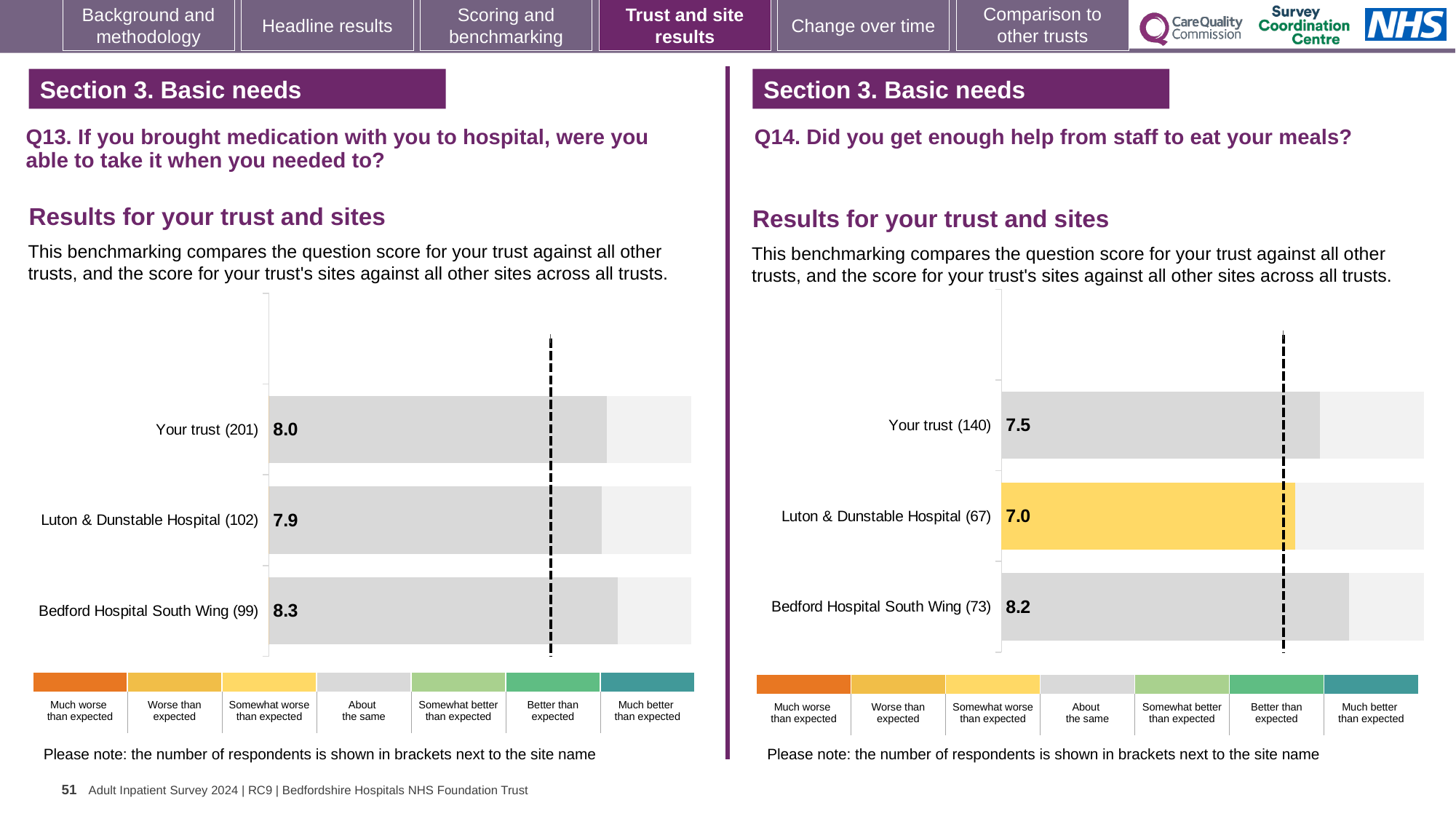
In the Q14 chart on the right, which benchmark category does the yellow colour of the Luton & Dunstable Hospital bar represent? Somewhat worse than expected In the Q13 chart on the left, what is the score for Bedford Hospital South Wing? 8.3 What type of chart is used for the Q13 results on the left? Bar chart In the Q14 chart on the right, what is the score for Luton & Dunstable Hospital? 7.0 In the Q13 chart on the left, how many respondents are shown for Your trust? 201 In the Q14 chart on the right, which has the larger score, Your trust or Luton & Dunstable Hospital? Your trust In the Q13 chart on the left, what is the difference between the scores for Bedford Hospital South Wing and Luton & Dunstable Hospital? 0.4 In the Q14 chart on the right, which site or trust has the highest score? Bedford Hospital South Wing In the Q14 chart on the right, what is the difference between the scores for Bedford Hospital South Wing and Your trust? 0.7 In the Q13 chart on the left, what is the score for Your trust? 8.0 In the Q13 chart on the left, which site or trust has the lowest score? Luton & Dunstable Hospital How many bars are plotted in the Q14 chart on the right? 3